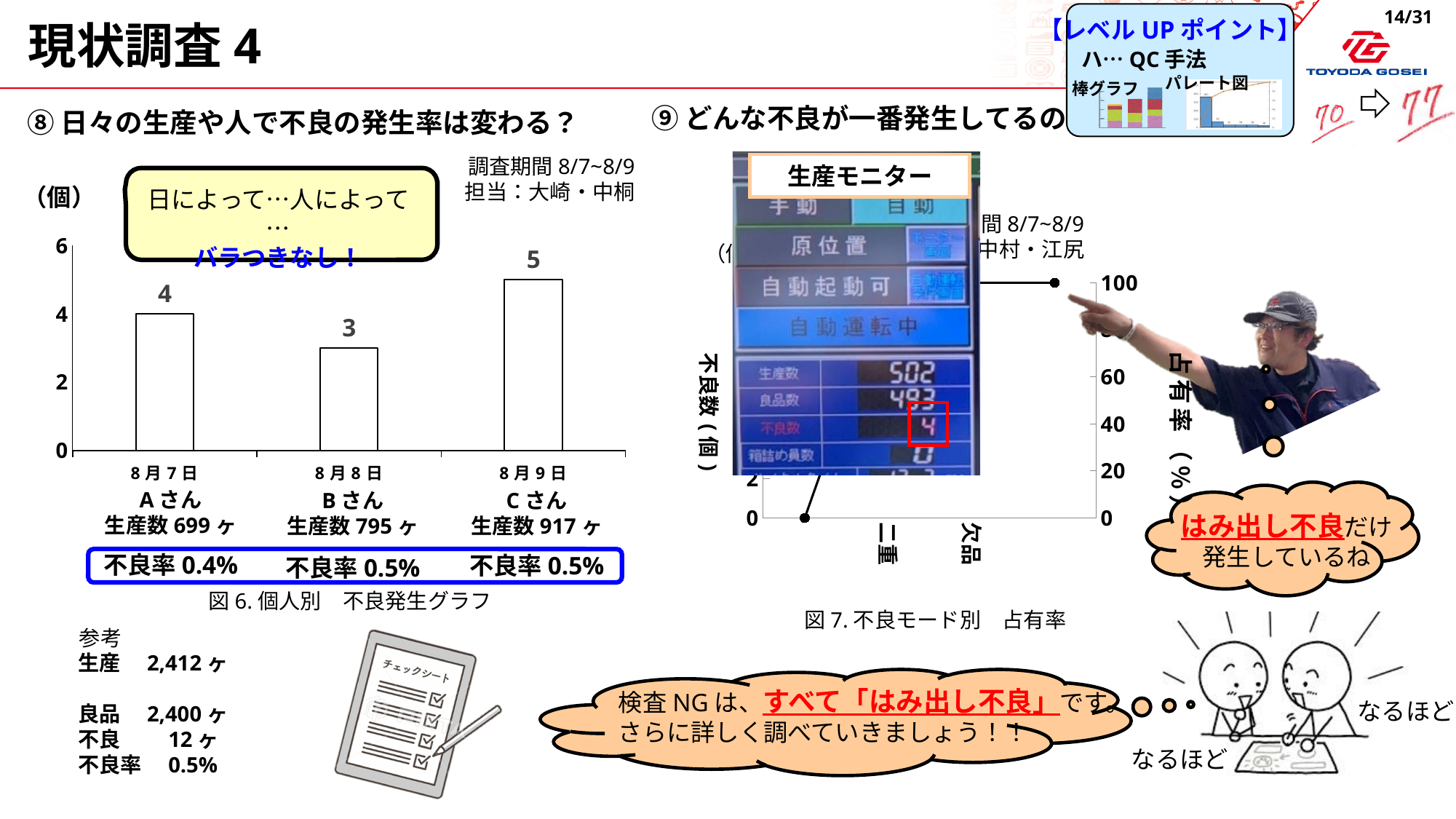
In 図6 (the left chart), what is the value for 8月7日? 4 In 図6 (the left chart), which date has the lowest value? 8月8日 In 図6 (the left chart), what is the value for 8月8日? 3 In 図7 (the right chart), what is the label of the right-hand axis? 占有率（%） In 図6 (the left chart), which is larger, the value for 8月7日 or 8月8日? 8月7日 In 図6 (the left chart), what is the unit shown on the y axis? 個 What kind of chart is 図6 (the left chart)? bar chart In 図6 (the left chart), which date has the highest value? 8月9日 In 図6 (the left chart), how many dates are plotted? 3 In 図6 (the left chart), what is the value for 8月9日? 5 In 図7 (the right chart), what value does the cumulative line reach at 欠品 on the right-hand axis? 100 In 図6 (the left chart), what is the difference between the values for 8月9日 and 8月8日? 2